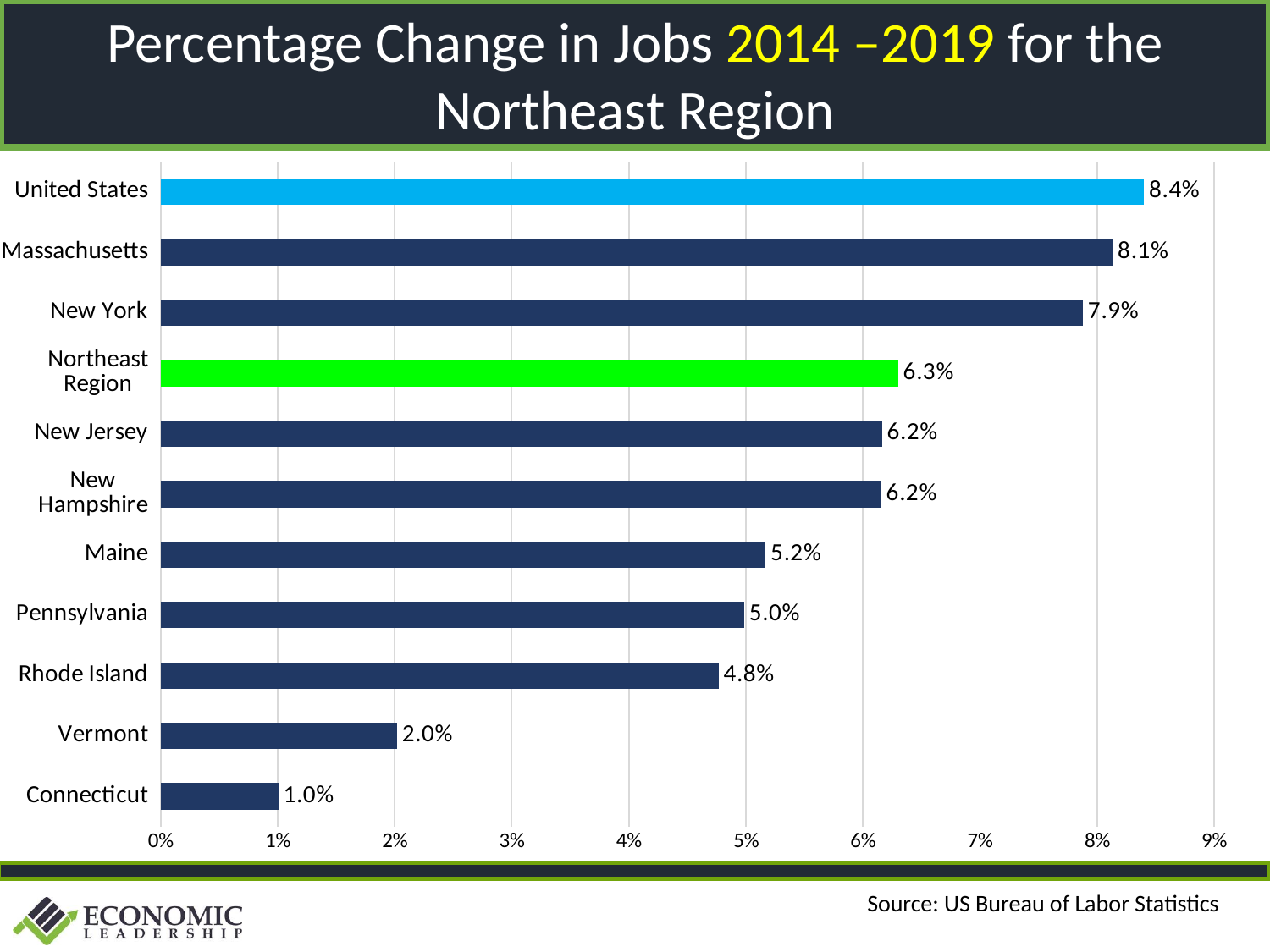
Which has a larger percentage change in jobs, Maine or Pennsylvania? Maine What is the source cited for the chart data? US Bureau of Labor Statistics What is the percentage change in jobs for the Northeast Region? 6.3% What is the percentage change in jobs for Rhode Island? 4.8% Which category has the lowest percentage change in jobs? Connecticut What is the percentage change in jobs for Connecticut? 1.0% What is the difference between the percentage change for the United States and for New York? 0.5% Which category has the highest percentage change in jobs? United States How many categories are shown on the chart? 11 What is the percentage change in jobs for Massachusetts? 8.1% What kind of chart is shown on the slide? Bar chart Is the value for Vermont greater or less than 3%? less